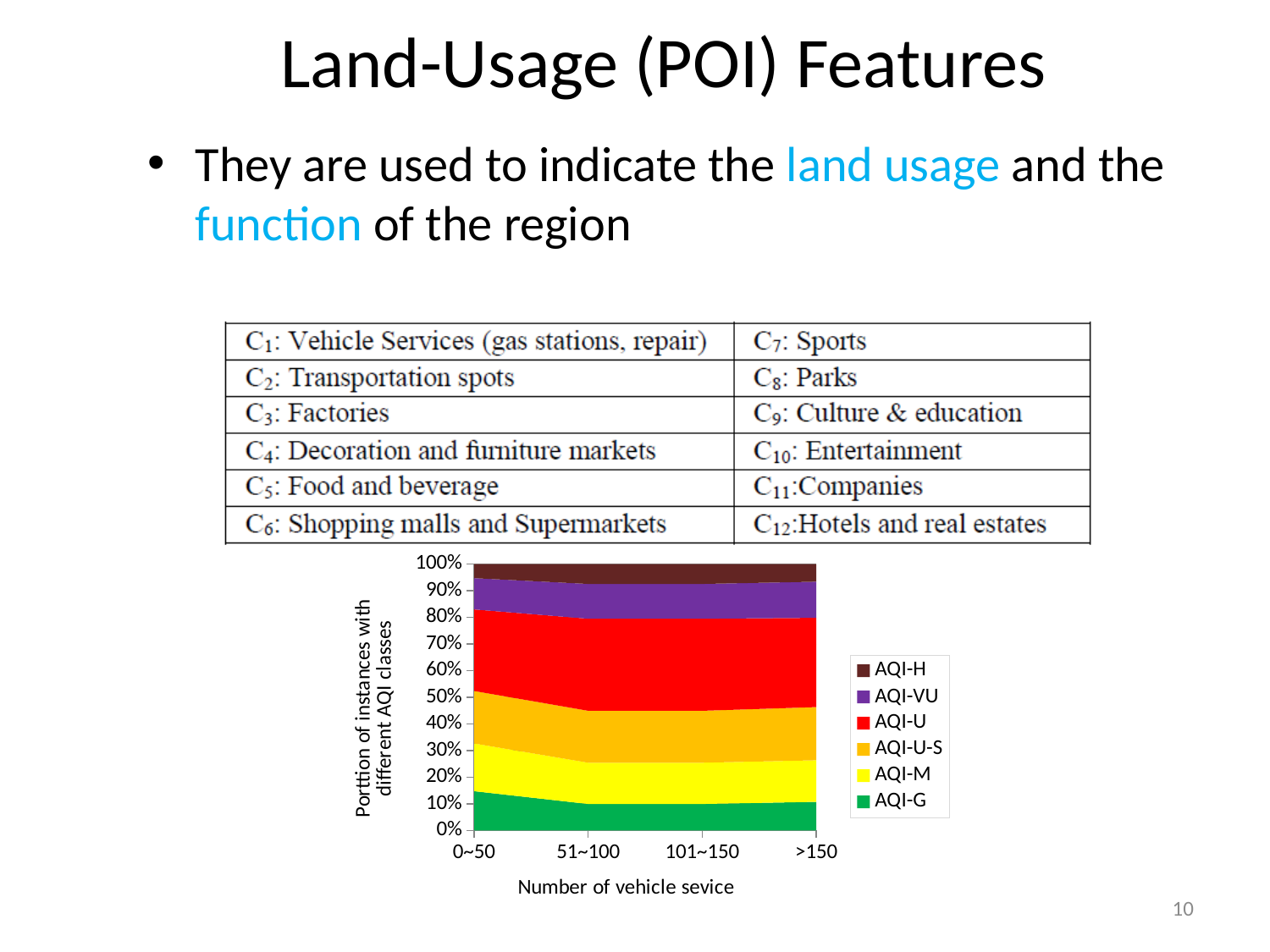
What is the label of the x axis of the chart? Number of vehicle sevice Is the share of AQI-G in the 0~50 category greater or less than 10%? greater Is the share of AQI-U in the 51~100 category greater or less than 20%? greater How many categories are shown on the x axis of the chart? 4 Which legend entry is shown in red in the chart? AQI-U Which AQI class takes the largest share of instances in the 0~50 category? AQI-U What is the last category on the x axis of the chart? >150 In the 0~50 category, which has a larger share: AQI-U or AQI-G? AQI-U How many series does the chart's legend list? 6 What kind of chart is shown at the bottom of the slide? Stacked area chart